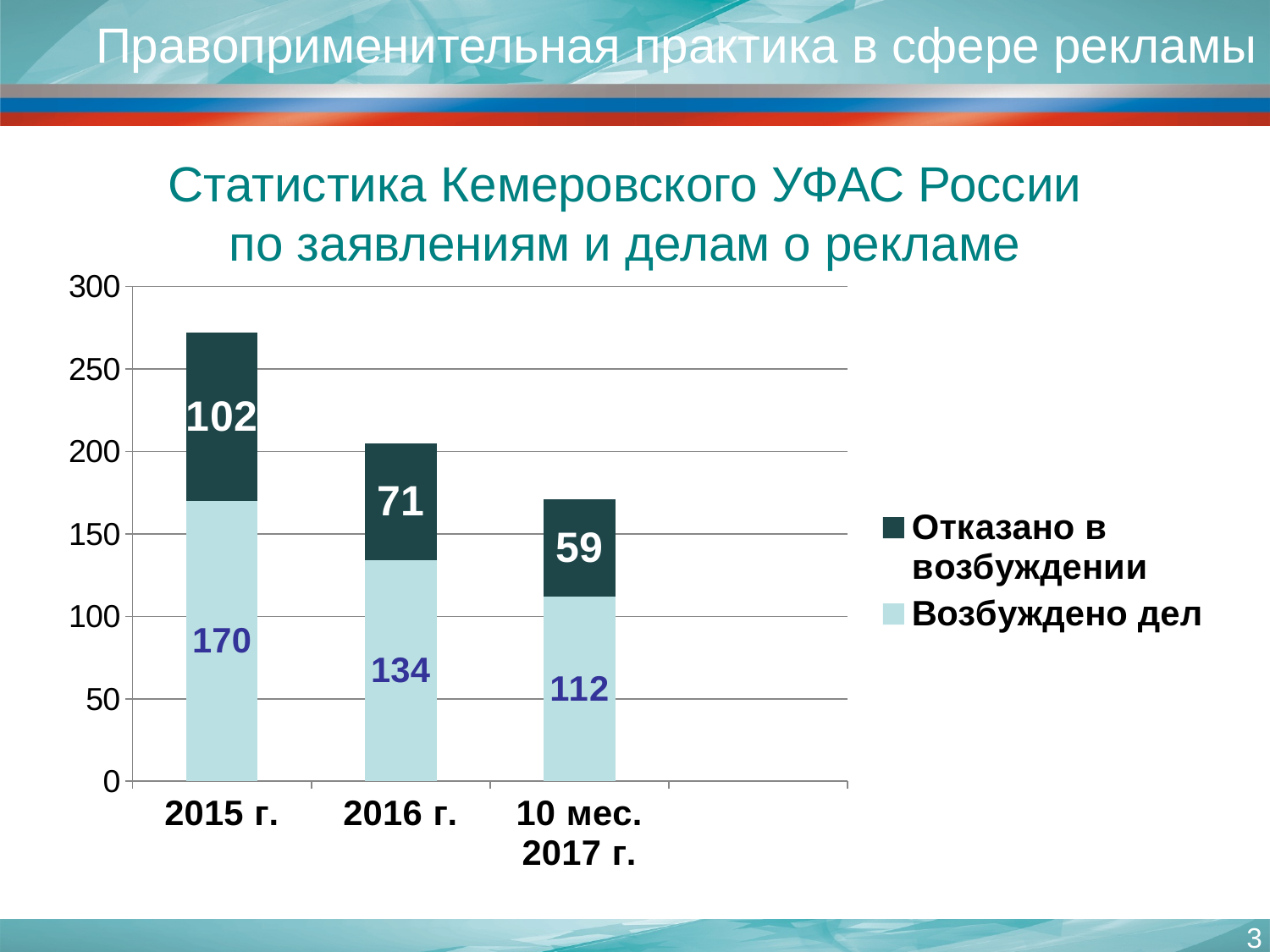
What is the total of the stacked bar for 2016 г.? 205 How many categories are shown on the x axis? 3 Which is larger: "Отказано в возбуждении" in 2015 г. or in 2016 г.? 2015 г. What is the value for "Отказано в возбуждении" in 2016 г.? 71 How many series does the legend list? 2 Which category has the lowest value for "Отказано в возбуждении"? 10 мес. 2017 г. What is the difference between the "Возбуждено дел" values for 2015 г. and 2016 г.? 36 What is the value for "Возбуждено дел" in 2015 г.? 170 What is the value for "Отказано в возбуждении" in 10 мес. 2017 г.? 59 What kind of chart is shown on the slide? Stacked bar chart What is the total of the stacked bar for 2015 г.? 272 Which category has the highest value for "Возбуждено дел"? 2015 г.